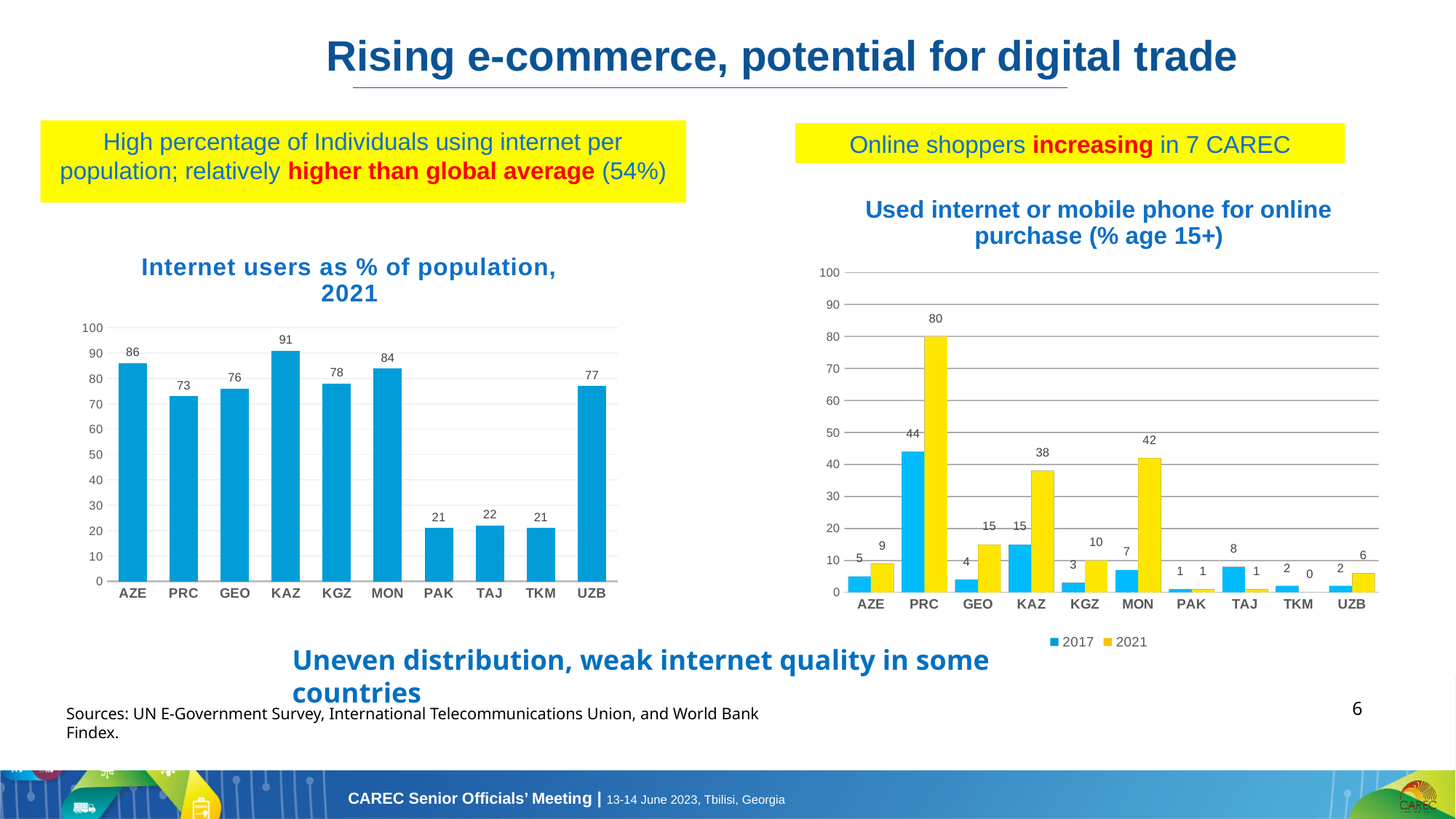
In the 'Internet users as % of population, 2021' chart, what is the difference between AZE and PRC? 13 In the 'Internet users as % of population, 2021' chart, how many countries are shown? 10 In the 'Used internet or mobile phone for online purchase (% age 15+)' chart, which country has the highest 2021 value? PRC In the 'Internet users as % of population, 2021' chart, which is larger, the value for MON or the value for UZB? MON In the 'Internet users as % of population, 2021' chart, which country has the highest value? KAZ In the 'Used internet or mobile phone for online purchase (% age 15+)' chart, what is the difference between the 2021 and 2017 values for MON? 35 In the 'Used internet or mobile phone for online purchase (% age 15+)' chart, how many series does the legend list? 2 What kind of chart is the 'Used internet or mobile phone for online purchase (% age 15+)' chart? Bar chart In the 'Internet users as % of population, 2021' chart, what is the value for KAZ? 91 In the 'Used internet or mobile phone for online purchase (% age 15+)' chart, what is the 2021 value for PRC? 80 In the 'Used internet or mobile phone for online purchase (% age 15+)' chart, which colour represents the 2021 series? Yellow In the 'Used internet or mobile phone for online purchase (% age 15+)' chart, what is the 2017 value for KAZ? 15